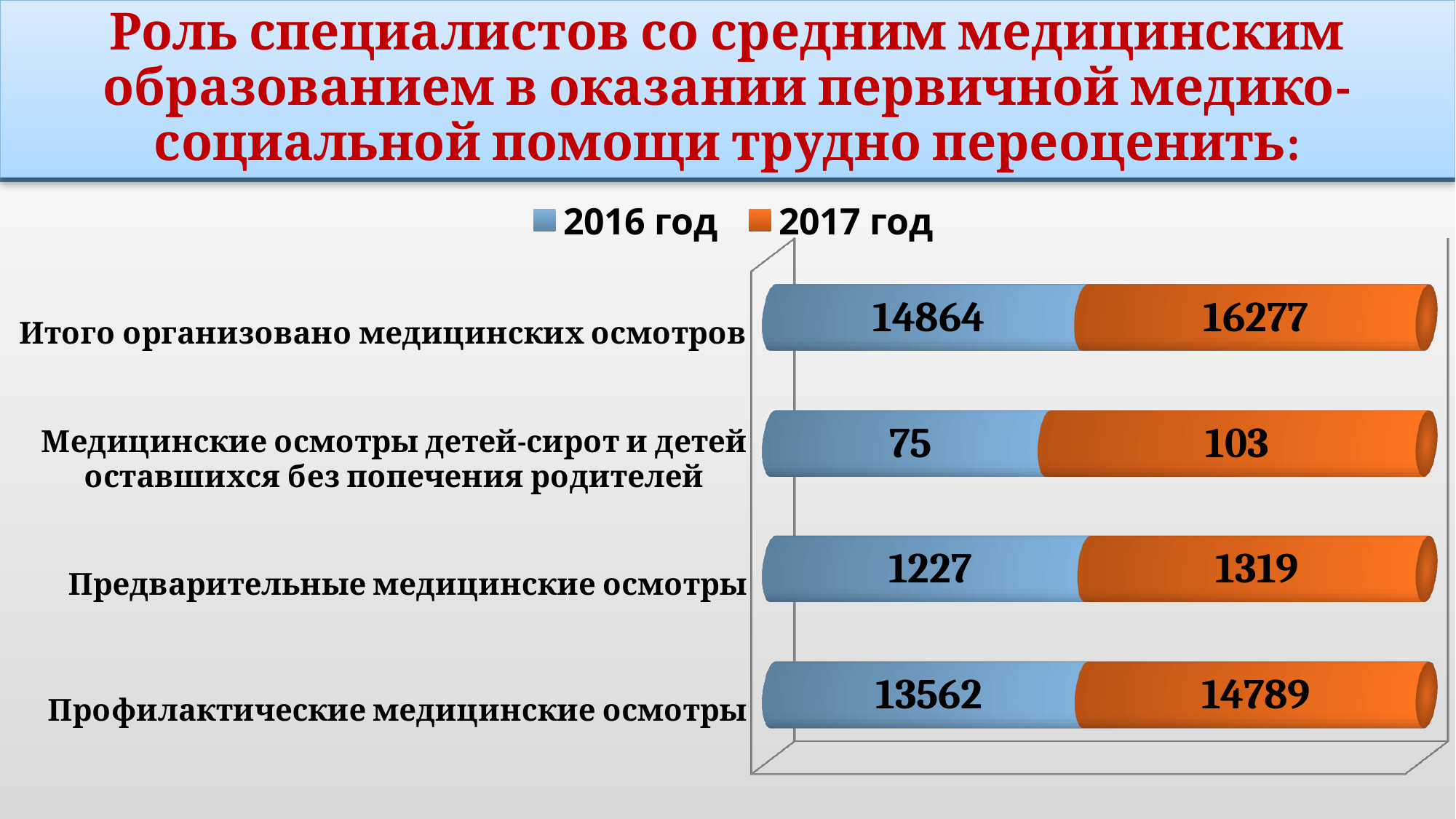
What is the value for 2017 год for Итого организовано медицинских осмотров? 16277 What is the difference between the 2017 год and 2016 год values for Профилактические медицинские осмотры? 1227 Which category has the highest 2017 год value? Итого организовано медицинских осмотров How many categories are shown in the chart? 4 Which is larger for Предварительные медицинские осмотры: the 2016 год value or the 2017 год value? 2017 год What is the value for 2016 год for Медицинские осмотры детей-сирот и детей оставшихся без попечения родителей? 75 How many series does the legend list? 2 What kind of chart is shown on the slide? Bar chart Which category has the lowest 2016 год value? Медицинские осмотры детей-сирот и детей оставшихся без попечения родителей What is the difference between the 2017 год and 2016 год values for Итого организовано медицинских осмотров? 1413 What is the value for 2017 год for Предварительные медицинские осмотры? 1319 What is the value for 2016 год for Профилактические медицинские осмотры? 13562